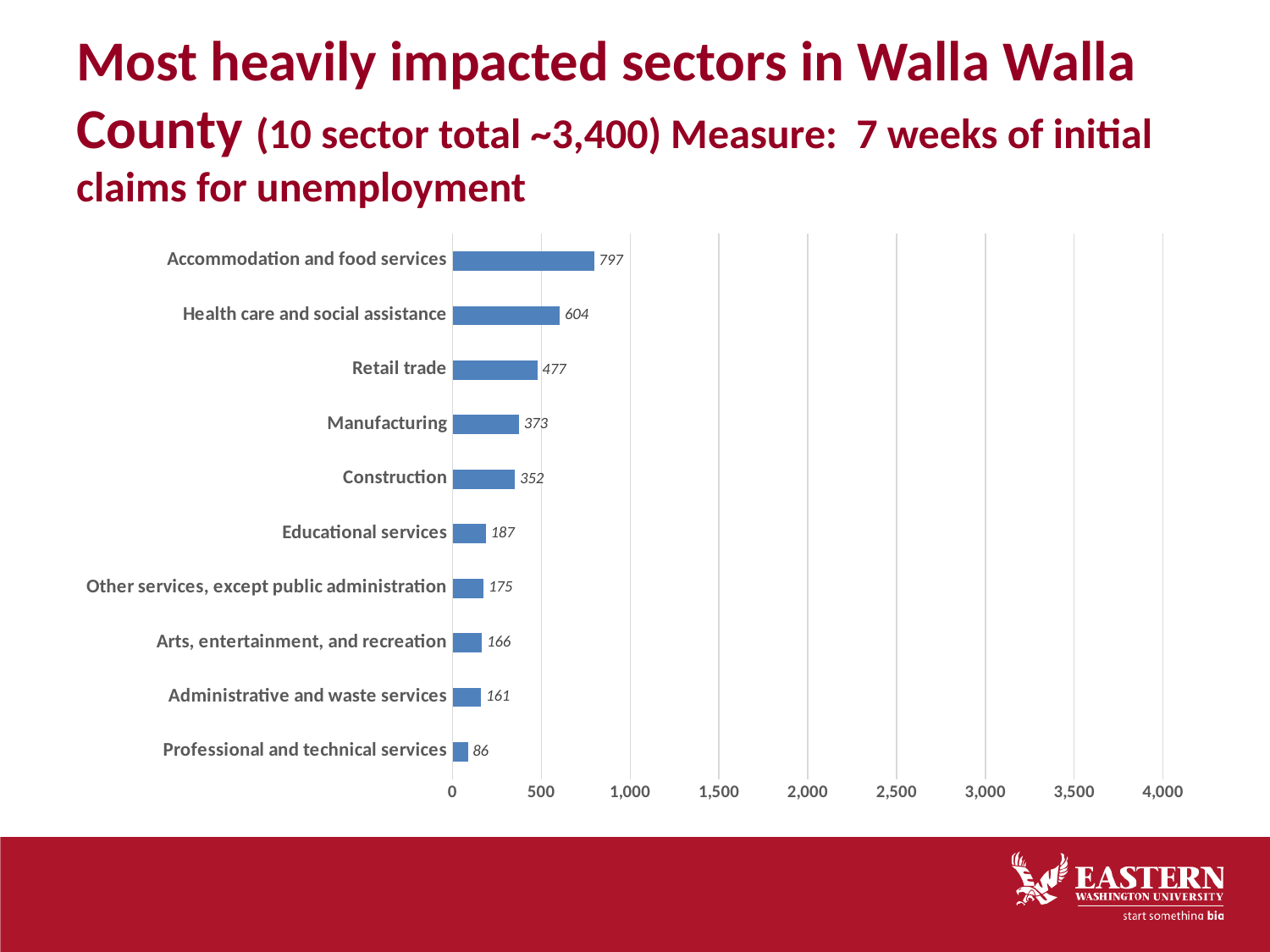
What is the value for Accommodation and food services? 797 Which sector has the highest value? Accommodation and food services What is the difference between Retail trade and Construction? 125 Which sector has the lowest value? Professional and technical services Which is larger, Manufacturing or Construction? Manufacturing What is the value for Manufacturing? 373 What kind of chart is shown on the slide? Bar chart What is the highest value shown on the horizontal axis? 4,000 How many sectors are shown in the chart? 10 What is the value for Professional and technical services? 86 What is the difference between Accommodation and food services and Health care and social assistance? 193 Is the value for Health care and social assistance greater or less than 500? greater